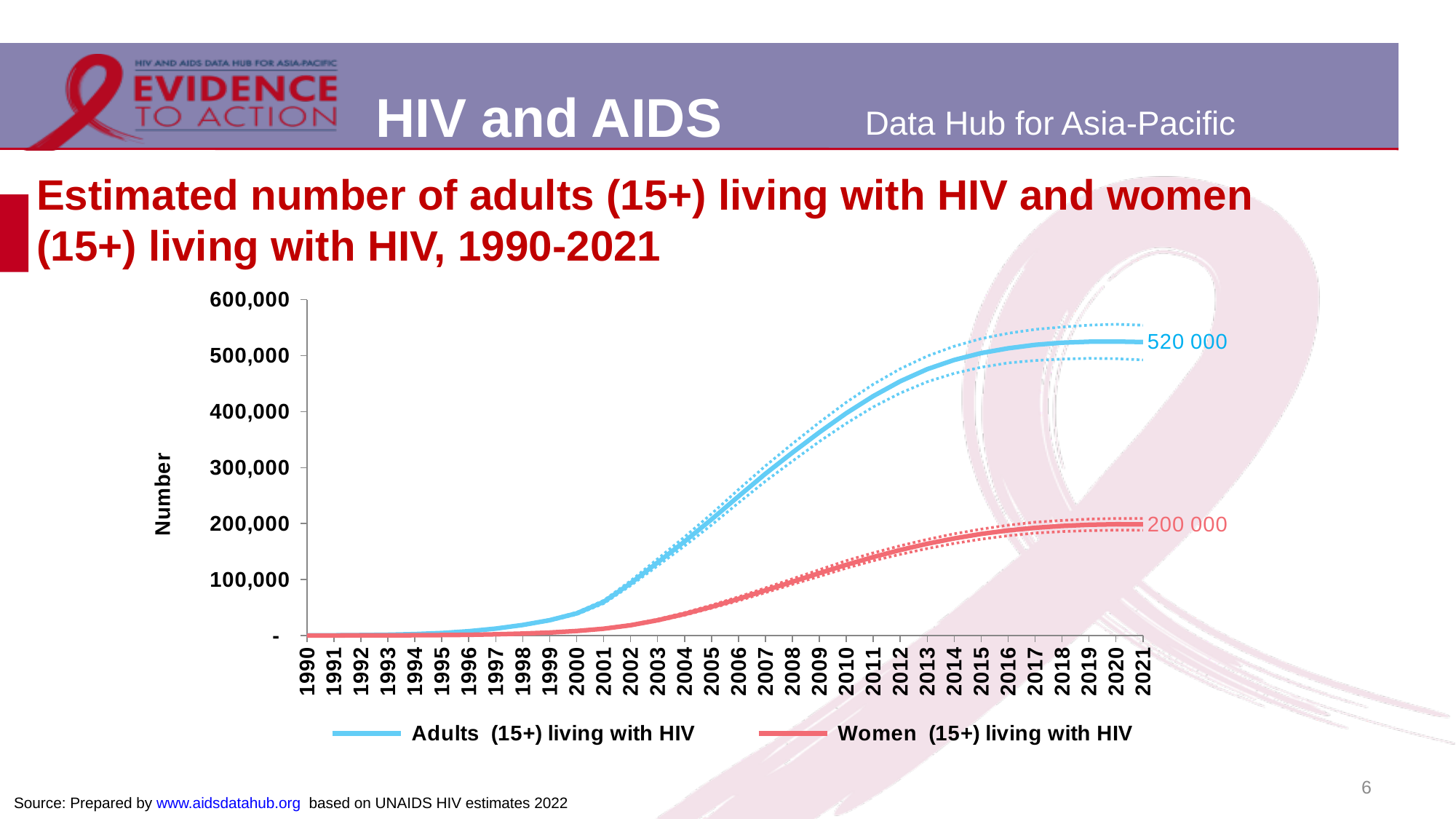
Which series has the higher value in 2021, adults (15+) living with HIV or women (15+) living with HIV? Adults (15+) living with HIV How many series does the legend list? 2 What kind of chart is shown on the slide? Line chart Do the values for adults (15+) living with HIV rise or fall from 1990 to 2021? Rise Is the value for women (15+) living with HIV in 2005 greater or less than 100,000? less Which colour represents women (15+) living with HIV in the chart? Red Is the value for adults (15+) living with HIV in 2000 greater or less than 100,000? less Is the value for adults (15+) living with HIV in 2010 greater or less than 300,000? greater What is the difference between the 2021 values for adults (15+) living with HIV and women (15+) living with HIV? 320 000 What is the label of the vertical axis? Number What is the estimated number of women (15+) living with HIV in 2021? 200 000 What is the estimated number of adults (15+) living with HIV in 2021? 520 000